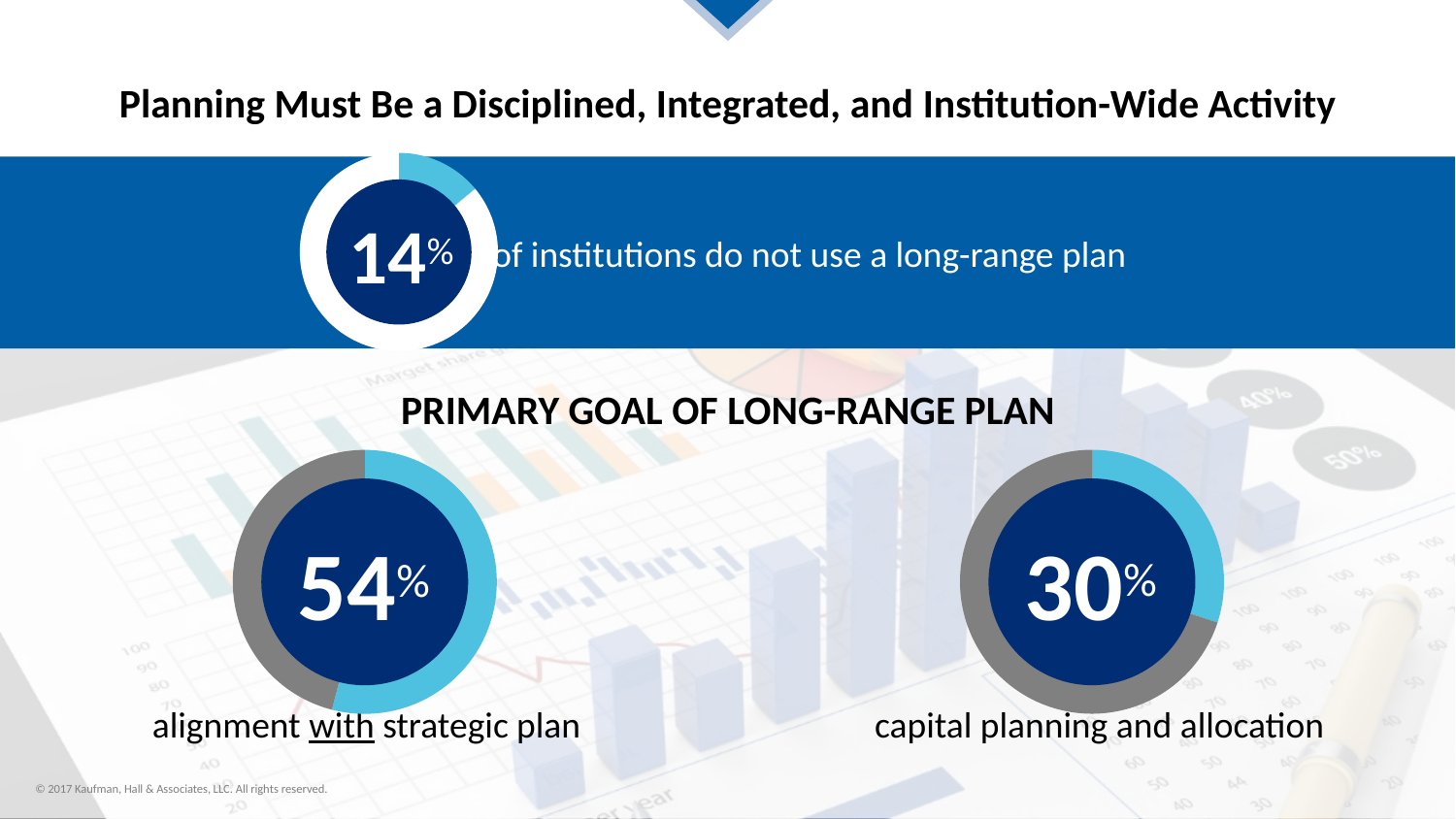
Among the two 'Primary Goal of Long-Range Plan' charts, which goal has the higher percentage? alignment with strategic plan What is the difference in percentage points between the 54% chart and the 14% chart? 40 What is the difference in percentage points between the alignment with strategic plan chart and the capital planning and allocation chart? 24 What percentage of institutions do not use a long-range plan, according to the top chart? 14% What kind of chart is used to display the 14% figure at the top of the slide? donut chart Among the two 'Primary Goal of Long-Range Plan' charts, which goal has the lower percentage? capital planning and allocation What is the heading above the two bottom donut charts? PRIMARY GOAL OF LONG-RANGE PLAN Is the value in the top chart (institutions not using a long-range plan) greater or less than 50%? less In the bottom-left chart under 'Primary Goal of Long-Range Plan', what percentage is shown for alignment with strategic plan? 54% Is the value in the alignment with strategic plan chart larger or smaller than the value in the capital planning and allocation chart? larger In the bottom-right chart under 'Primary Goal of Long-Range Plan', what percentage is shown for capital planning and allocation? 30% How many donut charts are shown on the slide? 3